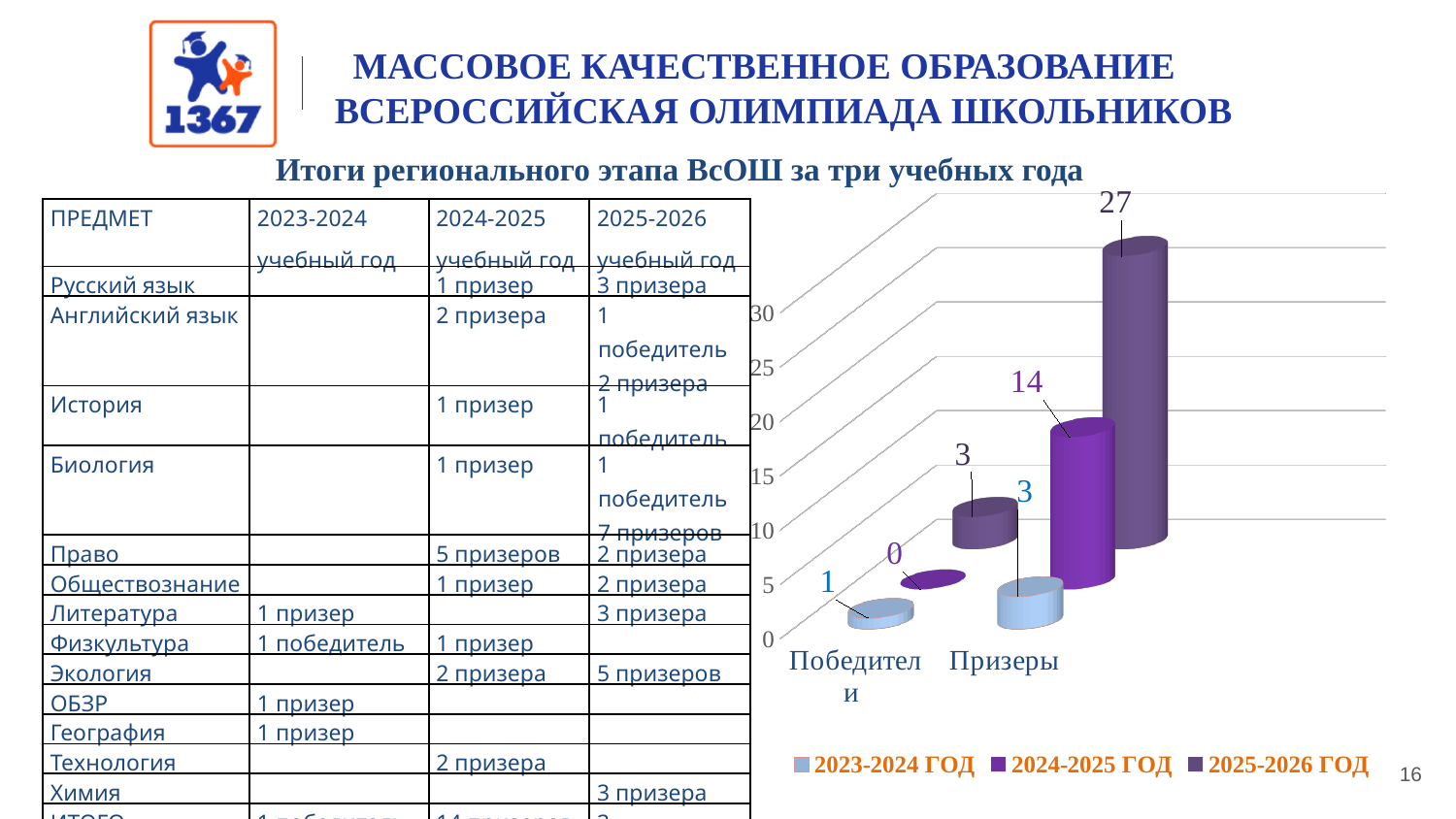
What is the value for Победители in the 2024-2025 ГОД series? 0 What is the value for Призеры in the 2024-2025 ГОД series? 14 Which is larger: the Победители value for 2025-2026 ГОД or the Призеры value for 2023-2024 ГОД? They are equal (3) Is the value for Призеры in the 2025-2026 ГОД series greater or less than 25? greater What is the difference between the Призеры values for 2025-2026 ГОД and 2024-2025 ГОД? 13 What is the value for Призеры in the 2025-2026 ГОД series? 27 Which series has the lowest value for Победители? 2024-2025 ГОД What type of chart is shown on the right side of the slide? bar chart How many series does the chart legend list? 3 How many categories are shown on the x axis of the chart? 2 Which series has the highest value for Призеры? 2025-2026 ГОД What is the value for Победители in the 2023-2024 ГОД series? 1